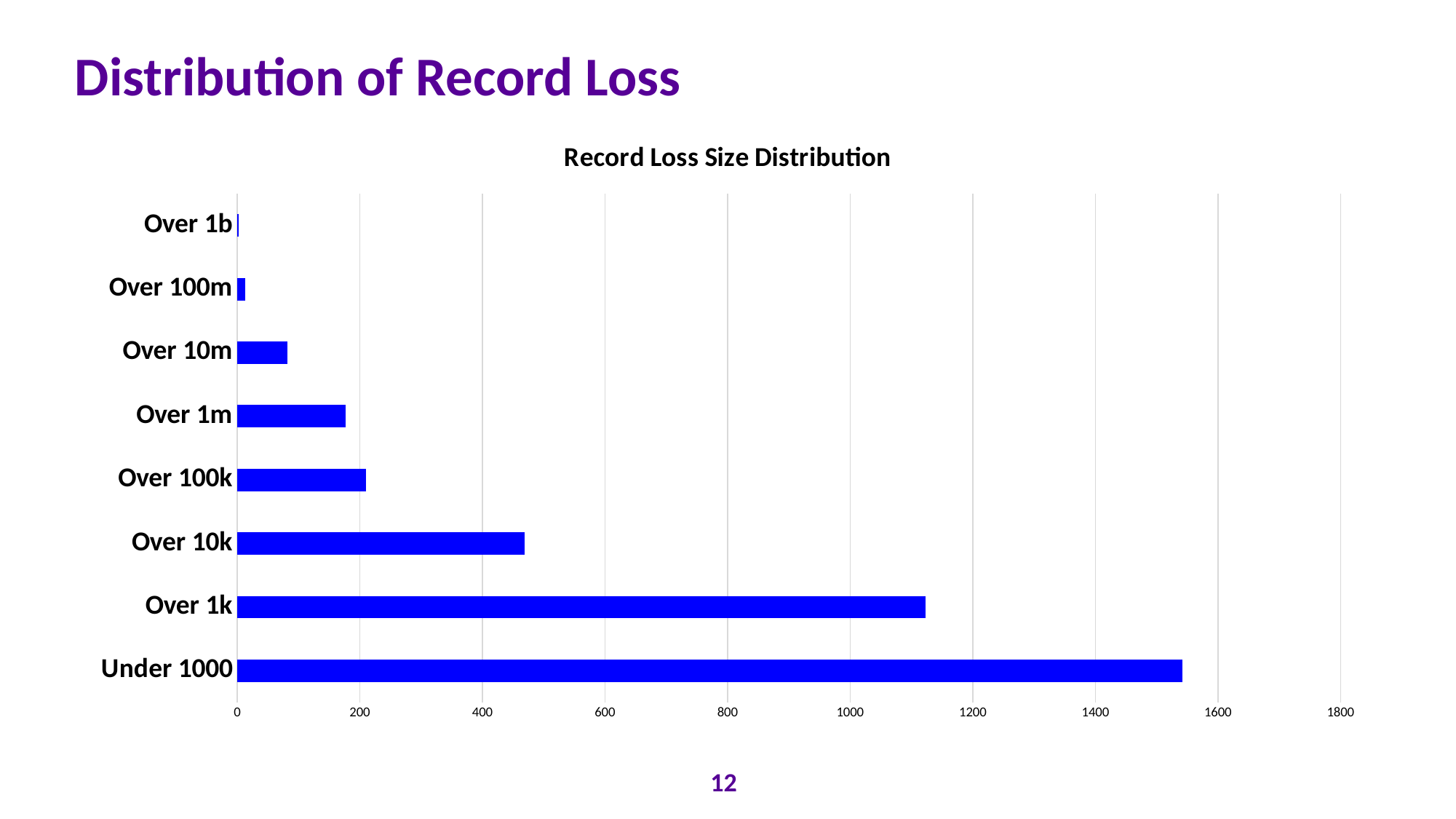
Which category has the lowest value in the Record Loss Size Distribution chart? Over 1b How many categories are plotted in the Record Loss Size Distribution chart? 8 Which is larger, the value for Over 1m or the value for Over 10m? Over 1m Is the value for Over 10k greater or less than 600? less Is the value for Over 10m greater or less than 200? less Which is larger, the value for Over 10k or the value for Over 100k? Over 10k What kind of chart is shown on the slide? bar chart Is the value for Over 10k greater or less than 400? greater Which category has the highest value in the Record Loss Size Distribution chart? Under 1000 What is the title of the chart on the slide? Record Loss Size Distribution